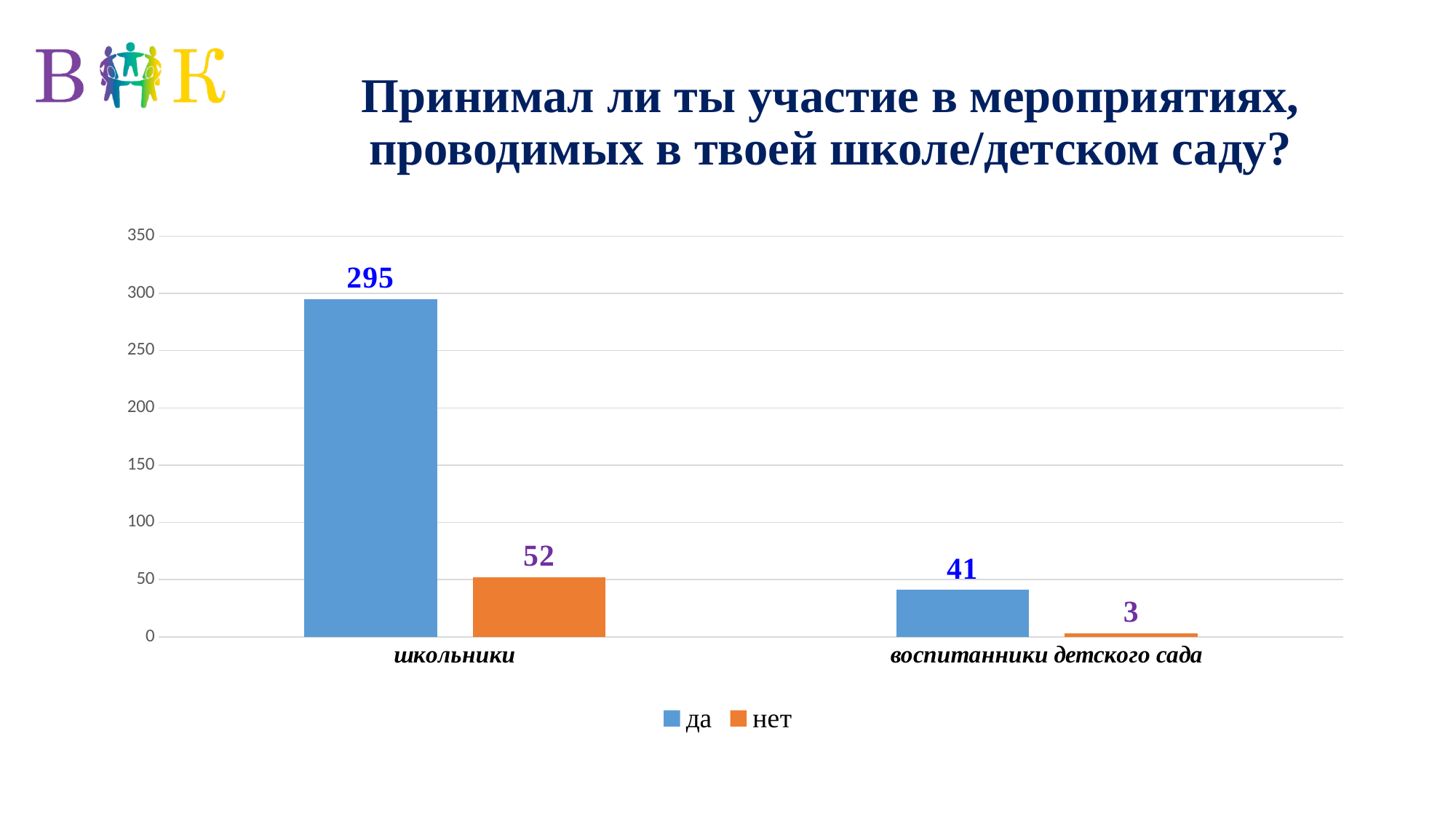
How many categories are shown on the x axis? 2 What is the value for "нет" in the "школьники" category? 52 What is the difference between the "да" and "нет" values for "школьники"? 243 Which category has the lowest "нет" value? воспитанники детского сада Which is larger: the "нет" value for "школьники" or the "да" value for "воспитанники детского сада"? нет for школьники How many series does the legend list? 2 What kind of chart is shown on the slide? bar chart Which category has the highest "да" value? школьники What colour are the bars for the "нет" series? orange What is the value for "да" in the "школьники" category? 295 What is the value for "да" in the "воспитанники детского сада" category? 41 What is the value for "нет" in the "воспитанники детского сада" category? 3